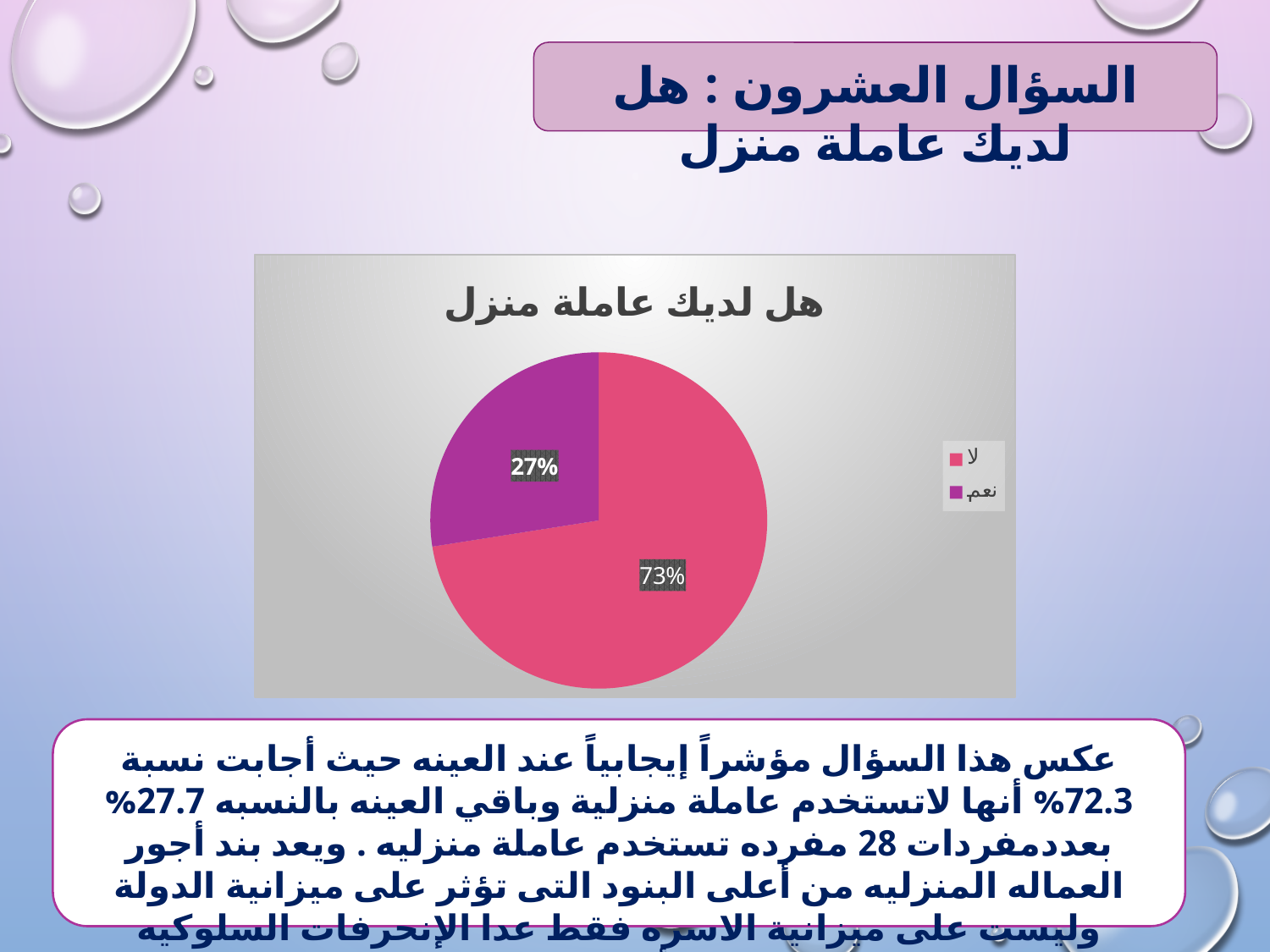
How many slices does the pie chart have? 2 What type of chart is shown on the slide? Pie chart How many entries does the legend list? 2 What percentage is shown for the 'لا' slice? 73% Which is larger, the 'لا' slice or the 'نعم' slice? لا What colour is the 'نعم' slice? Purple What is the title of the chart? هل لديك عاملة منزل What share of the pie does the 'لا' slice represent? 73% Which category has the smallest share of the pie? نعم What percentage is shown for the 'نعم' slice? 27% What is the difference in percentage points between the 'لا' slice and the 'نعم' slice? 46 Which category has the largest share of the pie? لا